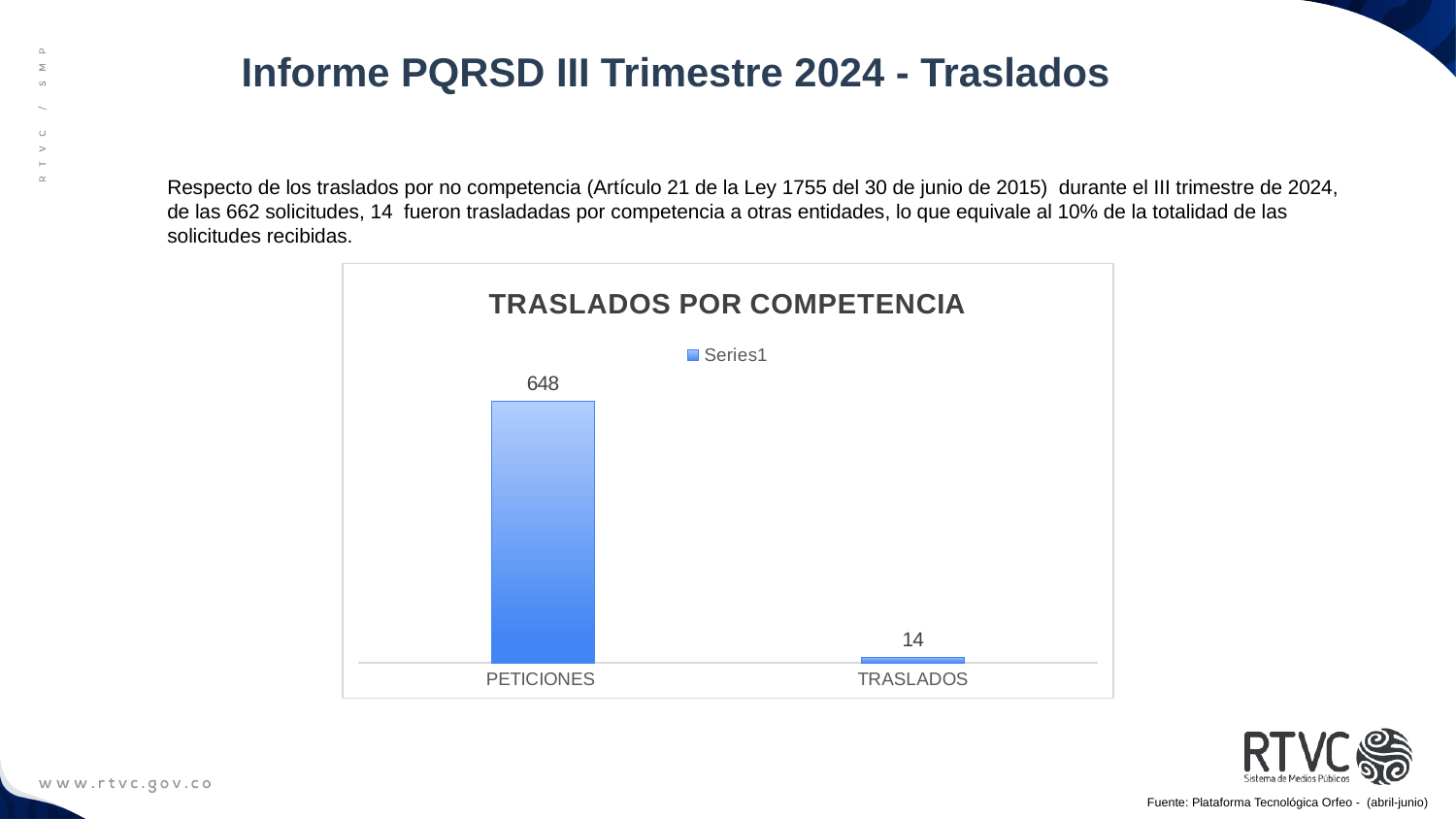
What is the value for TRASLADOS? 14 What is the total of the two values plotted in the chart? 662 Which category has the highest value? PETICIONES Which is larger, the value for PETICIONES or the value for TRASLADOS? PETICIONES What is the name of the series listed in the legend? Series1 What is the title of the chart? TRASLADOS POR COMPETENCIA How many categories are shown on the x axis? 2 Which category has the lowest value? TRASLADOS What is the value for PETICIONES? 648 What is the difference between the values for PETICIONES and TRASLADOS? 634 What kind of chart is shown? bar chart How many series does the legend list? 1